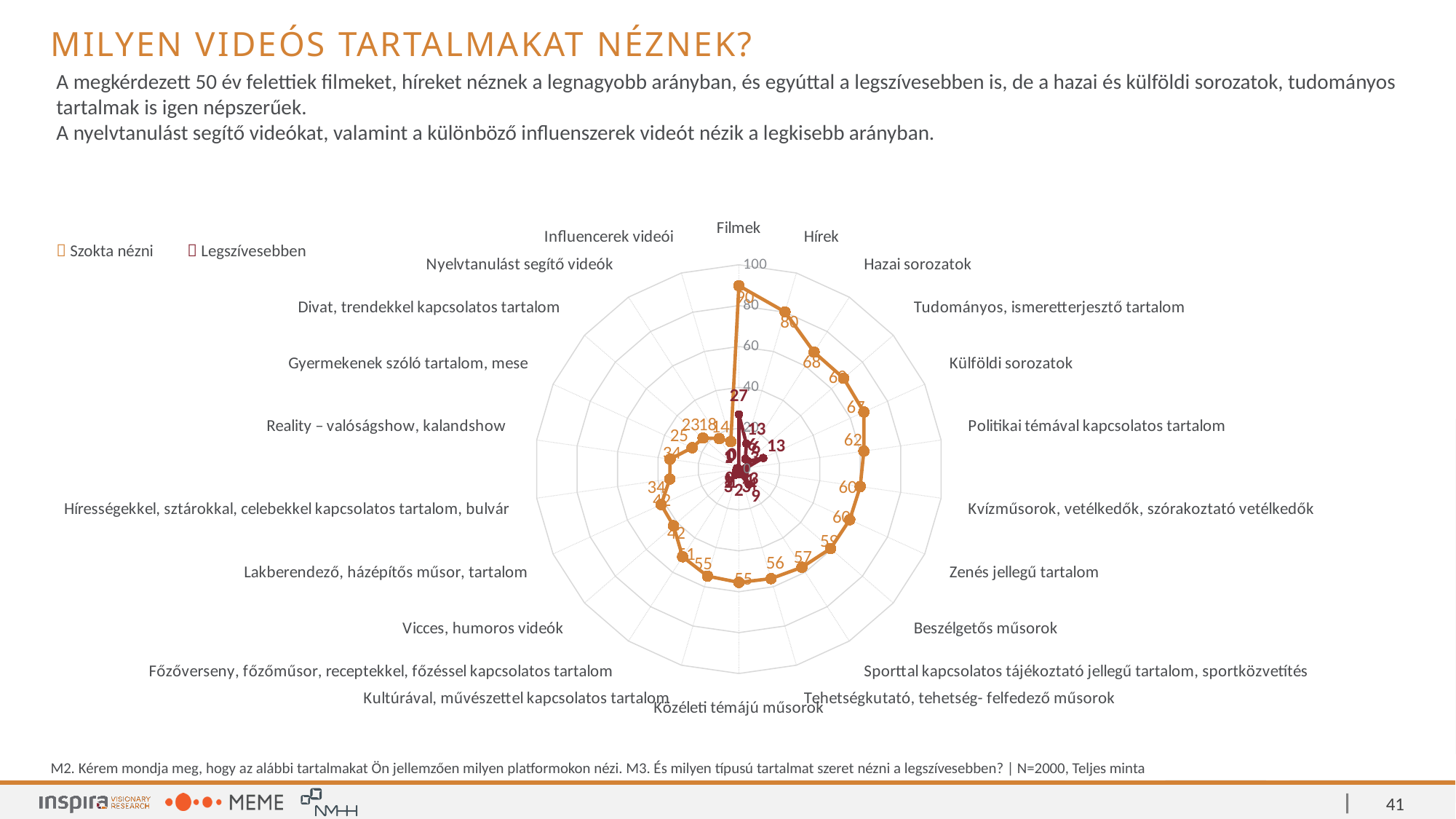
What is the 'Szokta nézni' value for Filmek? 90 What is the 'Legszívesebben' value for Filmek? 27 How many series does the chart legend list? 2 Which category has the highest 'Szokta nézni' value? Filmek What is the 'Szokta nézni' value for Hazai sorozatok? 68 What is the difference between the 'Szokta nézni' values for Filmek and Hírek? 10 What is the 'Szokta nézni' value for Hírek? 80 What kind of chart is shown on the slide? radar chart Is the 'Szokta nézni' value for Vicces, humoros videók greater or less than 60? less How many content categories are plotted around the radar chart? 22 Which category has the lowest 'Szokta nézni' value? Influencerek videói What are the two series named in the legend? Szokta nézni, Legszívesebben